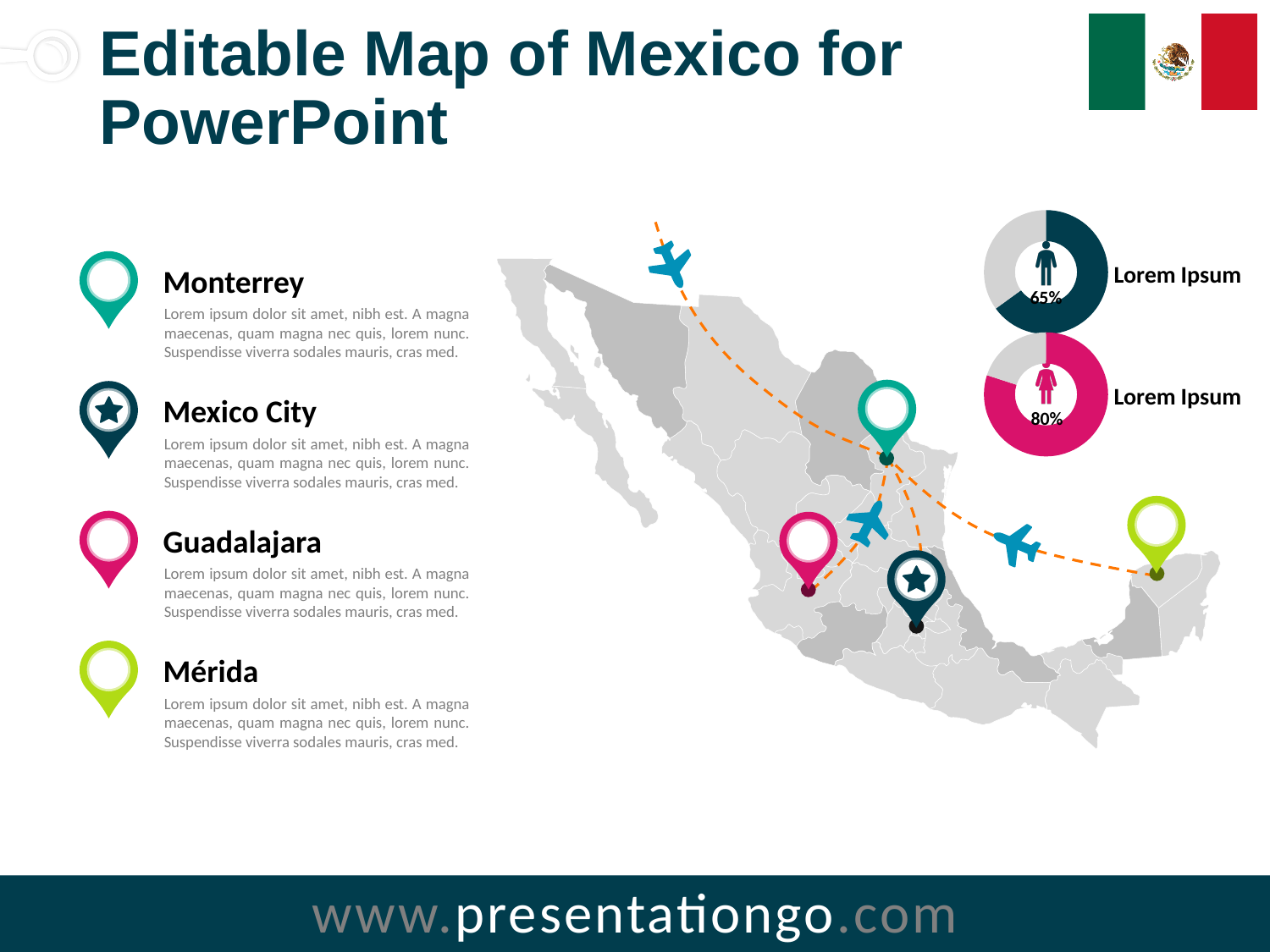
In the bottom donut chart, what share of the ring is left unfilled (grey)? 20% Is the value shown in the top donut chart greater or less than 50%? greater Which of the two donut charts on the right shows the larger percentage, the top one or the bottom one? the bottom one What is the difference between the percentage in the bottom donut chart and the percentage in the top donut chart? 15% What kind of chart is used to display the 65% and 80% values on the right of the slide? donut chart What colour is the filled portion of the top donut chart? dark teal In the top donut chart, what share of the ring is left unfilled (grey)? 35% What colour is the filled portion of the bottom donut chart? pink How many donut charts are shown on the slide? 2 In the top donut chart (with the male figure icon), what percentage is shown? 65% Is the value shown in the bottom donut chart greater or less than 75%? greater In the bottom donut chart (with the female figure icon), what percentage is shown? 80%